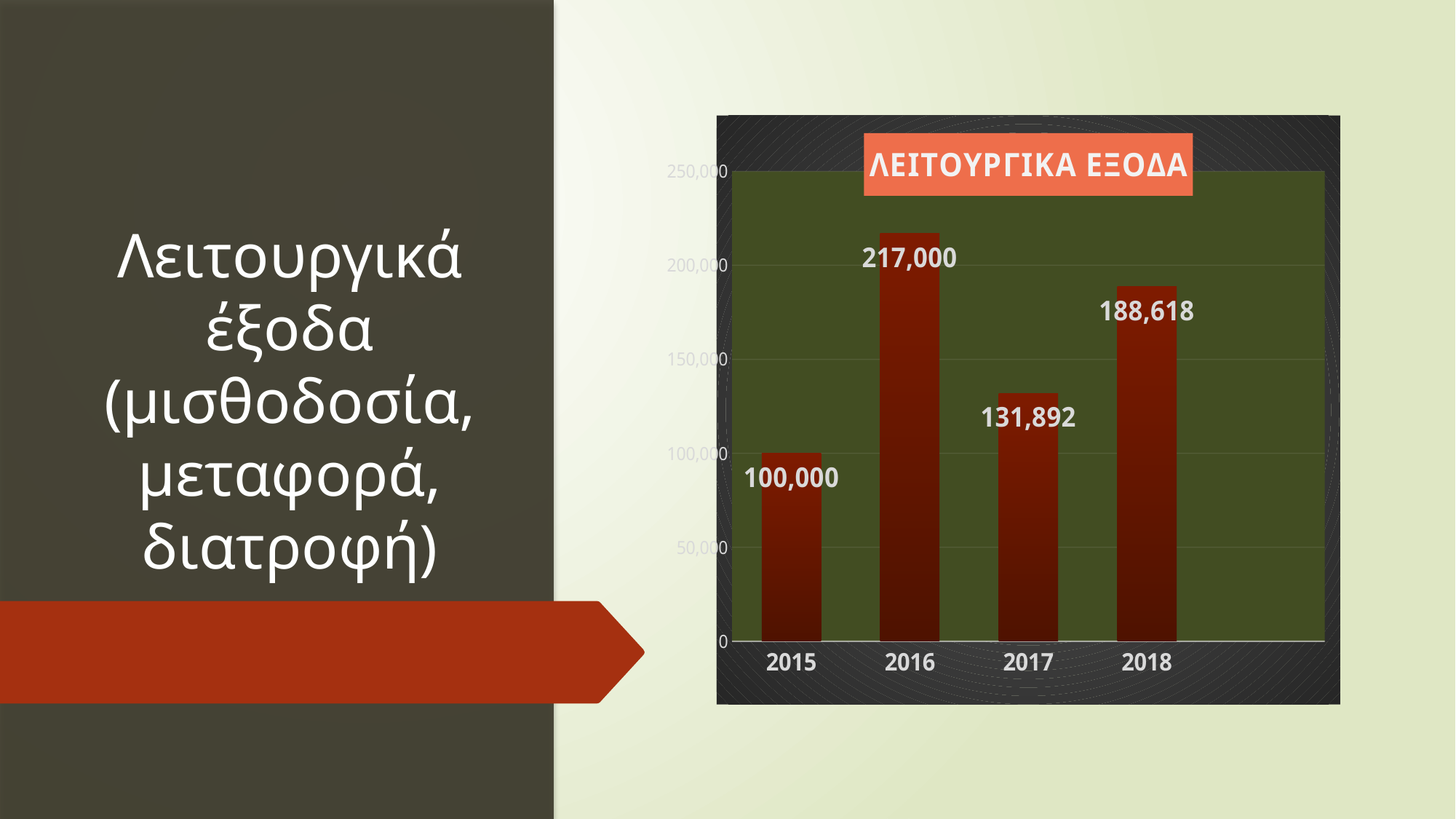
What is the difference between the values for 2018 and 2015? 88,618 Which year has the highest value? 2016 Is the value for 2016 greater or less than 200,000? greater What is the value for 2015? 100,000 Which year has the lowest value? 2015 What is the difference between the values for 2016 and 2017? 85,108 Which is larger, the value for 2017 or the value for 2018? 2018 How many years are shown on the x axis? 4 What is the value for 2018? 188,618 What is the title of the chart? ΛΕΙΤΟΥΡΓΙΚΑ ΕΞΟΔΑ What is the value for 2017? 131,892 What is the value for 2016? 217,000